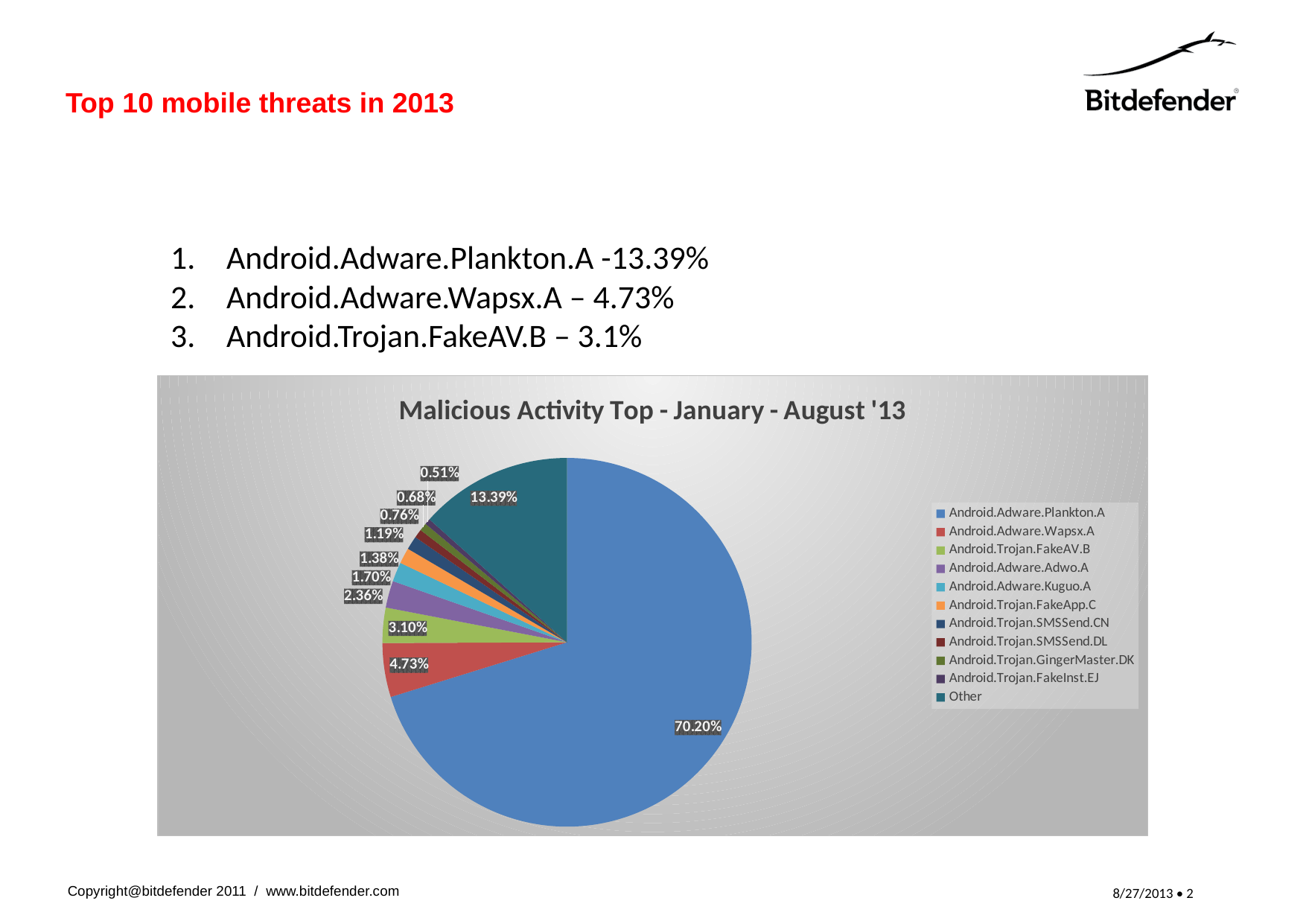
Which category has the largest slice of the pie? Android.Adware.Plankton.A Which category has the smallest slice of the pie? Android.Trojan.FakeInst.EJ What share of the pie does Android.Adware.Wapsx.A have? 4.73% Which is larger in the pie chart, Android.Adware.Adwo.A or Android.Trojan.FakeApp.C? Android.Adware.Adwo.A How many entries does the chart's legend list? 11 What is the title of the chart? Malicious Activity Top - January - August '13 What kind of chart is shown on the slide? pie chart What value is shown for Android.Trojan.SMSSend.CN in the pie chart? 1.19% What value is shown for Android.Adware.Kuguo.A in the pie chart? 1.70% What value is shown for Android.Trojan.FakeAV.B in the pie chart? 3.10% What value is shown for the Other slice in the pie chart? 13.39% What is the difference between the values for Android.Adware.Wapsx.A and Android.Trojan.FakeAV.B in the pie chart? 1.63%